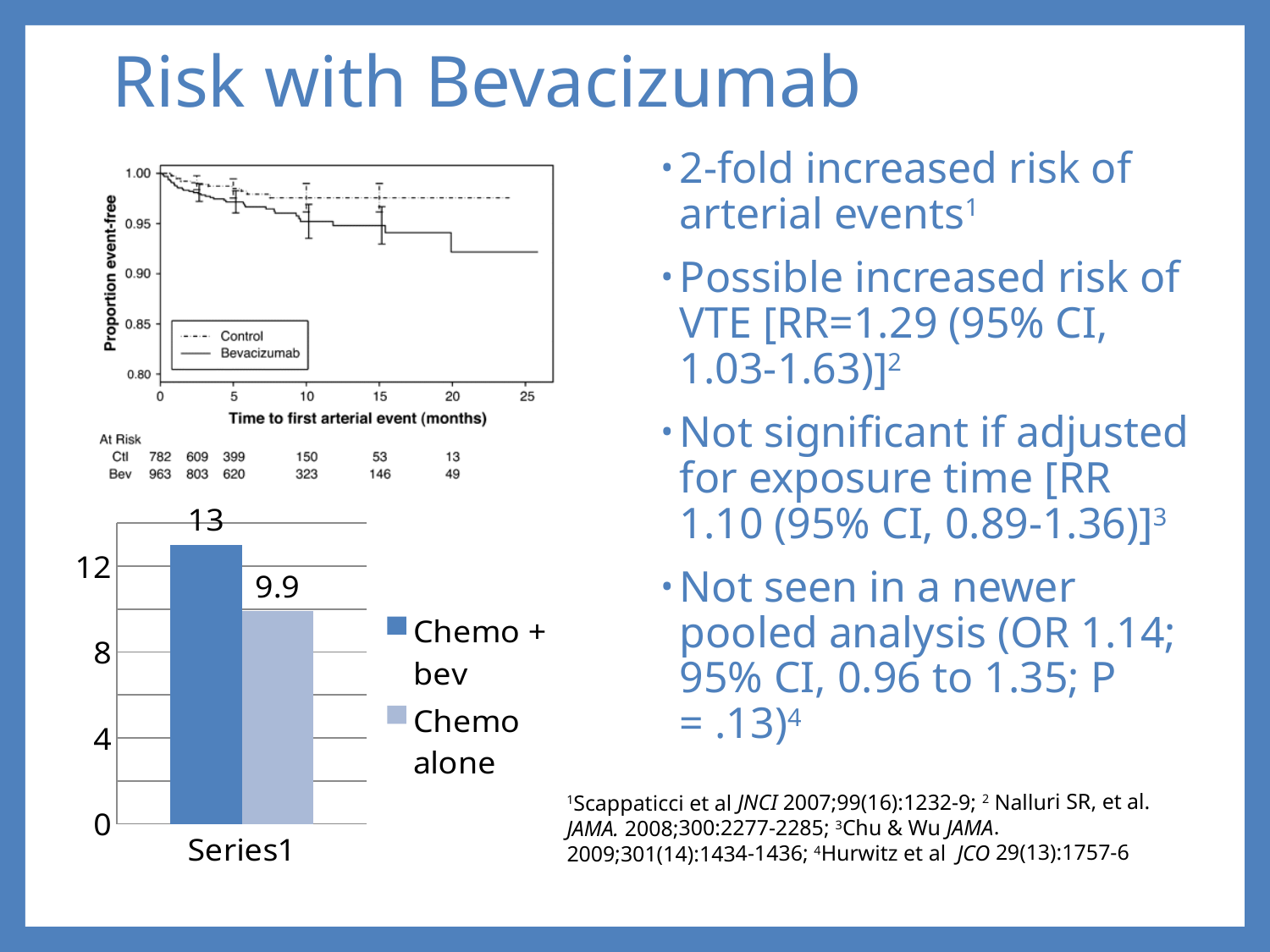
What kind of chart is shown at the bottom left of the slide? bar chart In the bar chart at the bottom left, what is the category label on the x axis? Series1 In the bar chart at the bottom left, what is the difference between the Chemo + bev value and the Chemo alone value? 3.1 In the bar chart at the bottom left, is the value for Chemo alone greater or less than 12? less In the line chart at the top left, does the Bevacizumab curve rise or fall as time increases? fall In the bar chart at the bottom left, how many series does the legend list? 2 In the bar chart at the bottom left, what is the value for Chemo alone? 9.9 In the bar chart at the bottom left, what is the value for Chemo + bev? 13 In the line chart at the top left, what is the label of the x axis? Time to first arterial event (months) In the bar chart at the bottom left, which series has the higher value? Chemo + bev In the bar chart at the bottom left, which series has the lower value? Chemo alone In the line chart at the top left, how many series does the legend list? 2